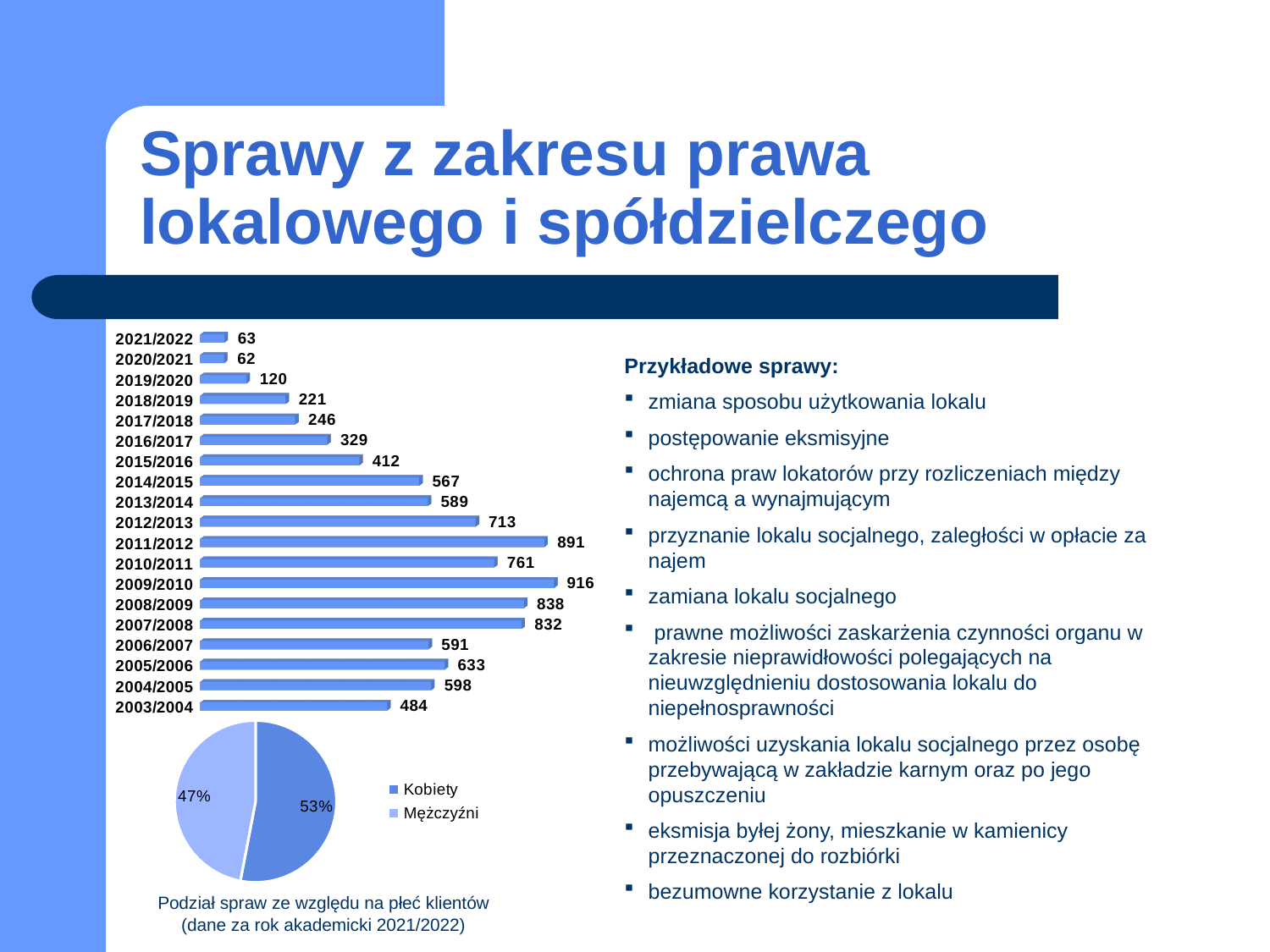
In the pie chart at the bottom left of the slide, what share is labelled for Kobiety? 53% How many entries does the legend of the pie chart at the bottom left of the slide list? 2 In the bar chart on the left of the slide, what is the value for 2009/2010? 916 In the bar chart on the left of the slide, which is larger, the value for 2005/2006 or the value for 2004/2005? 2005/2006 How many academic years are shown in the bar chart on the left of the slide? 19 In the pie chart at the bottom left of the slide, what share is labelled for Mężczyźni? 47% In the bar chart on the left of the slide, which academic year has the lowest value? 2020/2021 In the bar chart on the left of the slide, what is the difference between the values for 2011/2012 and 2010/2011? 130 In the bar chart on the left of the slide, what is the value for 2015/2016? 412 In the bar chart on the left of the slide, what is the value for 2003/2004? 484 In the bar chart on the left of the slide, which academic year has the highest value? 2009/2010 What kind of chart is the chart at the top left of the slide? bar chart